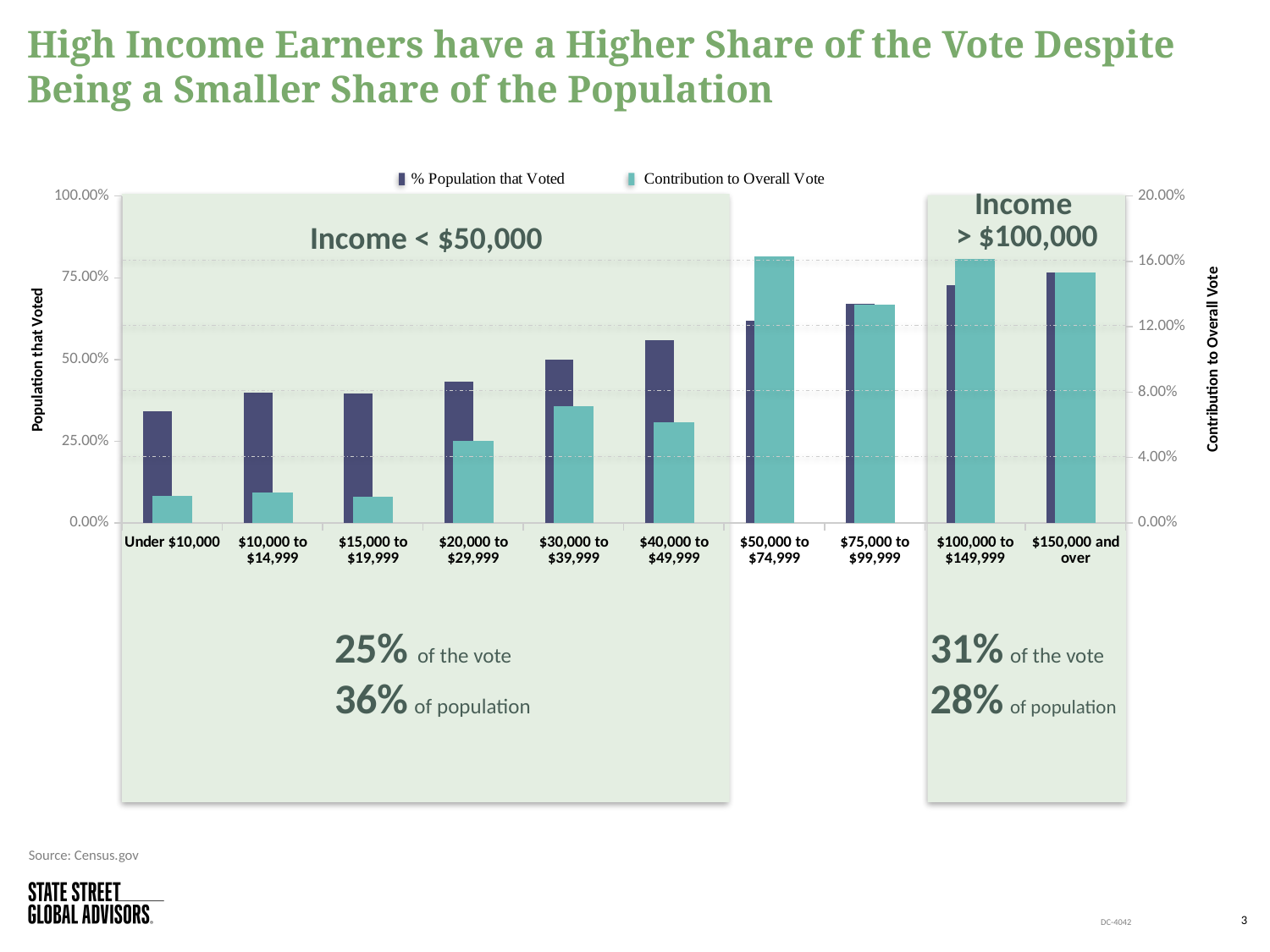
Which has a larger % Population that Voted: $75,000 to $99,999 or $40,000 to $49,999? $75,000 to $99,999 Is the Contribution to Overall Vote for $50,000 to $74,999 greater or less than 12.00%? greater How many series does the chart's legend list? 2 Is the % Population that Voted for $40,000 to $49,999 greater or less than 50.00%? greater What kind of chart is shown on the slide? Bar chart Which has a larger Contribution to Overall Vote: $20,000 to $29,999 or $30,000 to $39,999? $30,000 to $39,999 Which series in the legend is shown in teal? Contribution to Overall Vote Which income category has the lowest value for % Population that Voted? Under $10,000 Do the values for % Population that Voted generally rise or fall as income increases along the x axis? rise Is the % Population that Voted for Under $10,000 greater or less than 50.00%? less How many income categories are shown on the x axis of the chart? 10